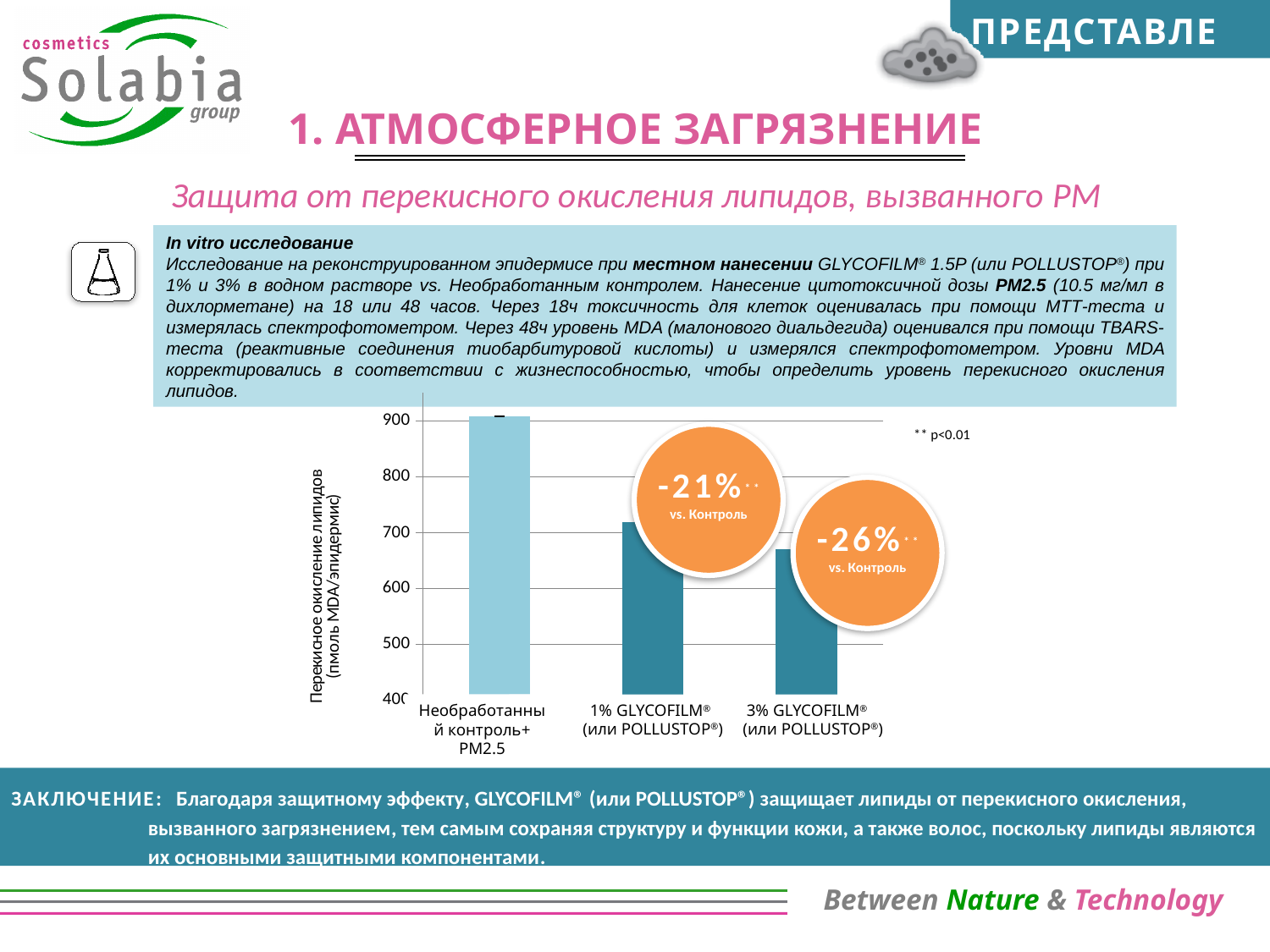
How many bars (categories) are plotted in the chart? 3 Is the value for 1% GLYCOFILM® (или POLLUSTOP®) greater or less than 700? greater Which category has the highest lipid peroxidation value? Необработанный контроль+ PM2.5 Do the bar values rise or fall from left to right across the categories? fall What percentage reduction vs. control is shown for 1% GLYCOFILM® (или POLLUSTOP®)? -21% What kind of chart is shown on the slide? bar chart Which category has the lowest lipid peroxidation value? 3% GLYCOFILM® (или POLLUSTOP®) Which is larger: the value for 1% GLYCOFILM® (или POLLUSTOP®) or for 3% GLYCOFILM® (или POLLUSTOP®)? 1% GLYCOFILM® (или POLLUSTOP®) What is the lowest value shown on the y axis of the chart? 400 What percentage reduction vs. control is shown for 3% GLYCOFILM® (или POLLUSTOP®)? -26% Is the value for 3% GLYCOFILM® (или POLLUSTOP®) greater or less than 700? less Is the value for Необработанный контроль+ PM2.5 greater or less than 800? greater